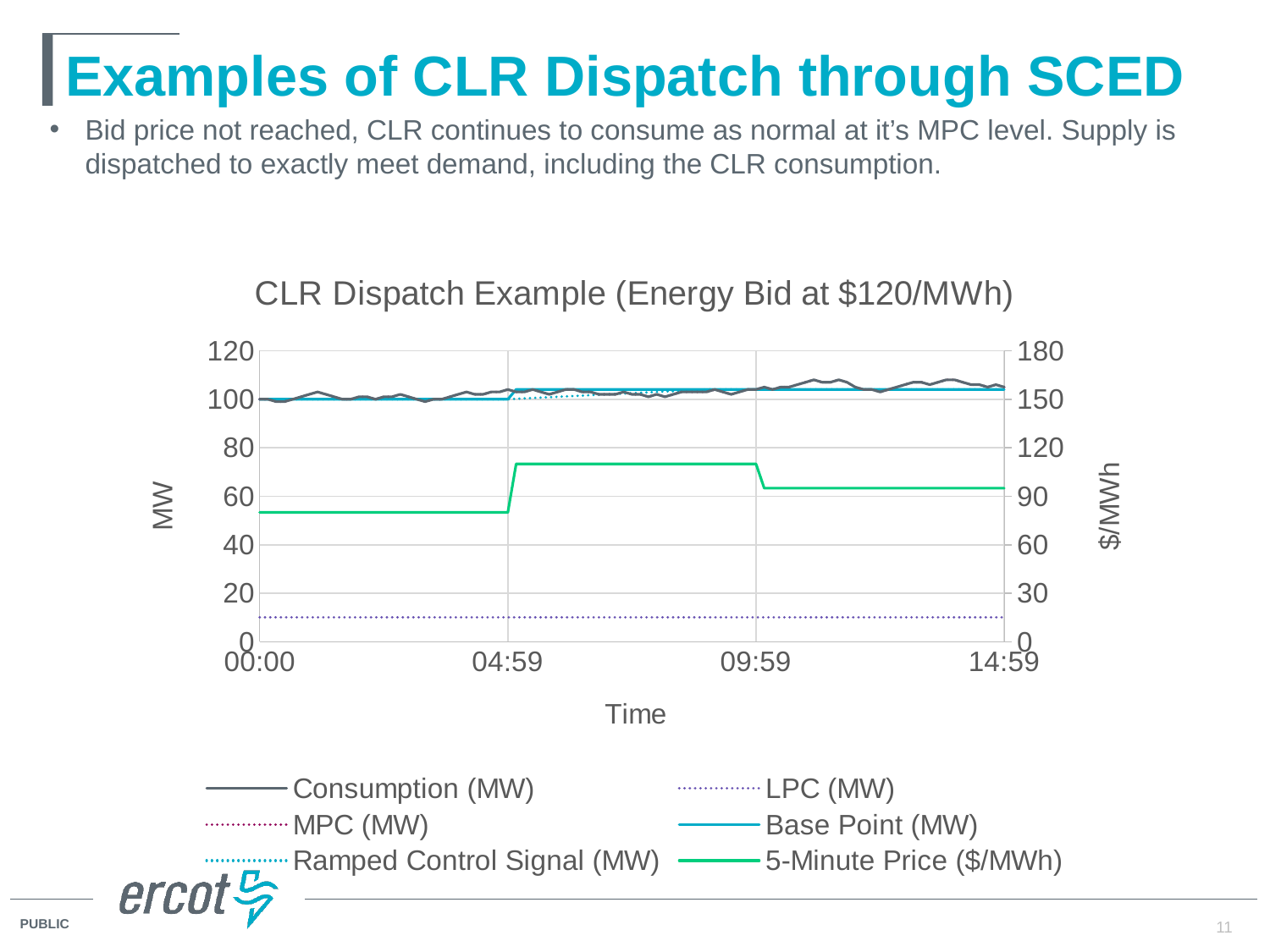
Is the value of the 5-Minute Price ($/MWh) at 00:00 greater or less than 90? less What is the title of the chart? CLR Dispatch Example (Energy Bid at $120/MWh) Which series is plotted at a higher MW level, LPC (MW) or MPC (MW)? MPC (MW) Is the value of Consumption (MW) at 00:00 greater or less than 80? greater What kind of chart is shown on the slide? line chart How many series does the chart legend list? 6 Is the value of LPC (MW) greater or less than 20? less How many time labels are shown on the x axis? 4 Is the 5-Minute Price ($/MWh) at 14:59 higher or lower than at 00:00? higher What is the label of the right-hand vertical axis? $/MWh